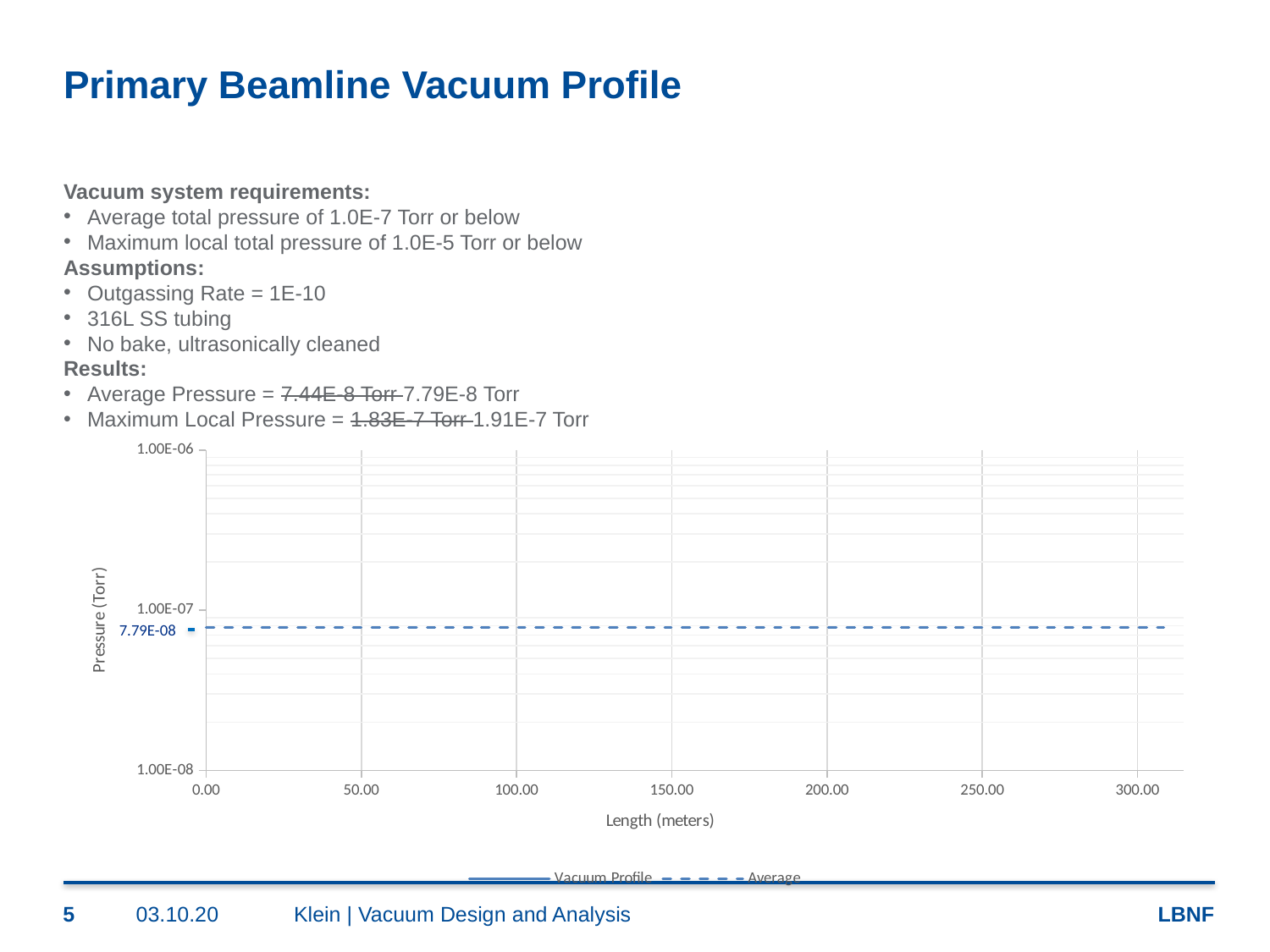
What is the lowest value labelled on the y axis? 1.00E-08 Is the Average line value greater or less than 1.00E-07? less What is the title of the x axis? Length (meters) What is the highest value labelled on the y axis? 1.00E-06 Is the Average line value greater or less than 1.00E-08? greater What kind of chart is shown on the slide? line chart What value is labelled on the dashed Average line? 7.79E-08 How many series does the chart legend list? 2 What is the title of the y axis? Pressure (Torr) What is the largest value labelled on the x axis? 300.00 Does the Average line rise, fall, or stay flat along the x axis? stays flat